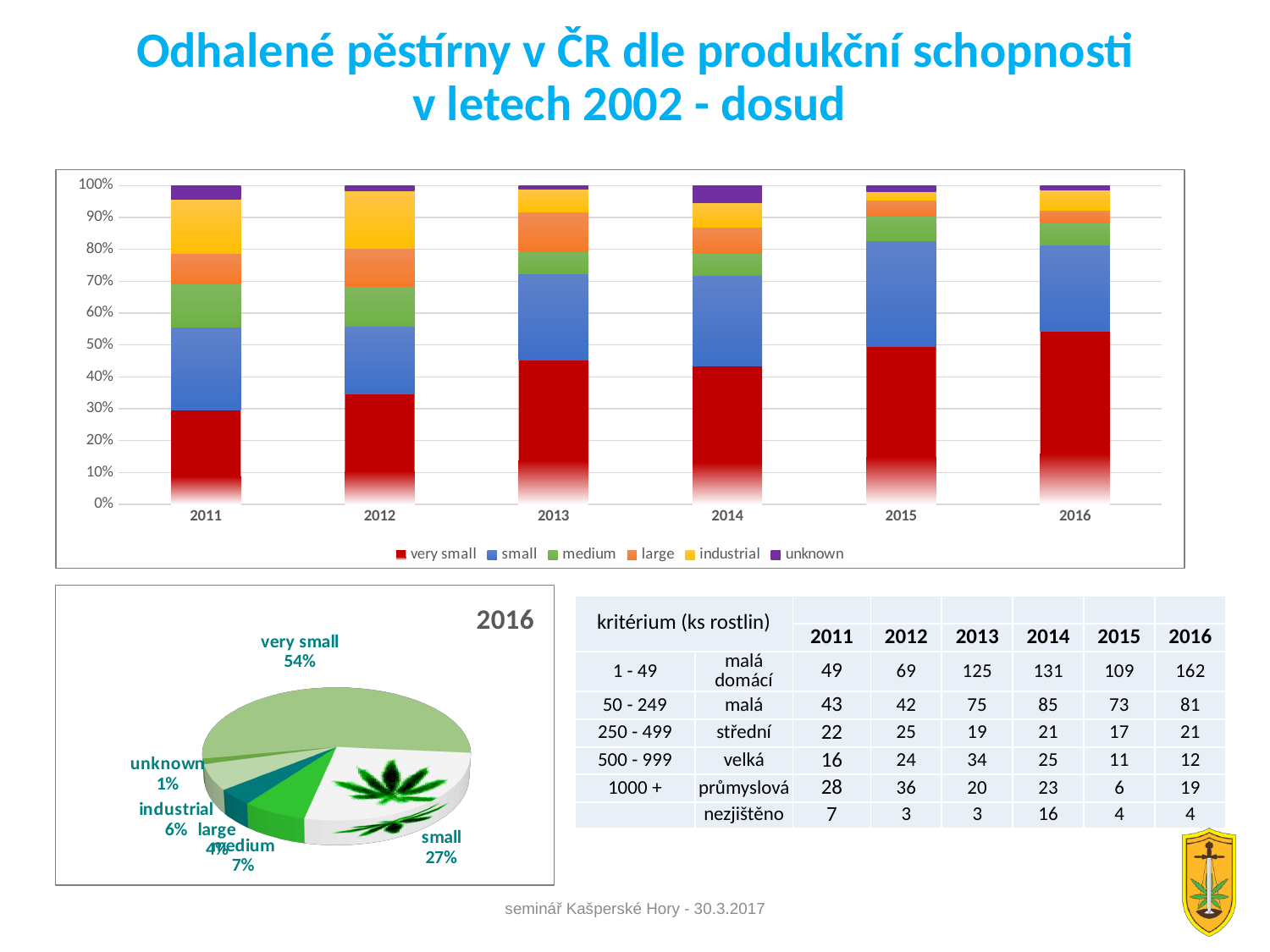
In the 2016 pie chart, what is the difference between the 'very small' and 'small' shares? 27% In the top stacked bar chart, is the 'very small' share for 2016 greater or less than 50%? greater What kind of chart is the bottom-left chart titled 2016? pie chart What kind of chart is the top chart on the slide? bar chart In the top stacked bar chart, is the 'very small' share for 2013 greater or less than 50%? less In the 2016 pie chart, what share does the 'very small' slice have? 54% How many years are shown on the x axis of the top stacked bar chart? 6 In the top stacked bar chart, which year has the larger 'very small' share, 2011 or 2016? 2016 How many series does the legend of the top stacked bar chart list? 6 In the top stacked bar chart, is the 'very small' share for 2012 greater or less than 30%? greater In the 2016 pie chart, which category has the largest slice? very small In the 2016 pie chart, which category has the smallest slice? unknown